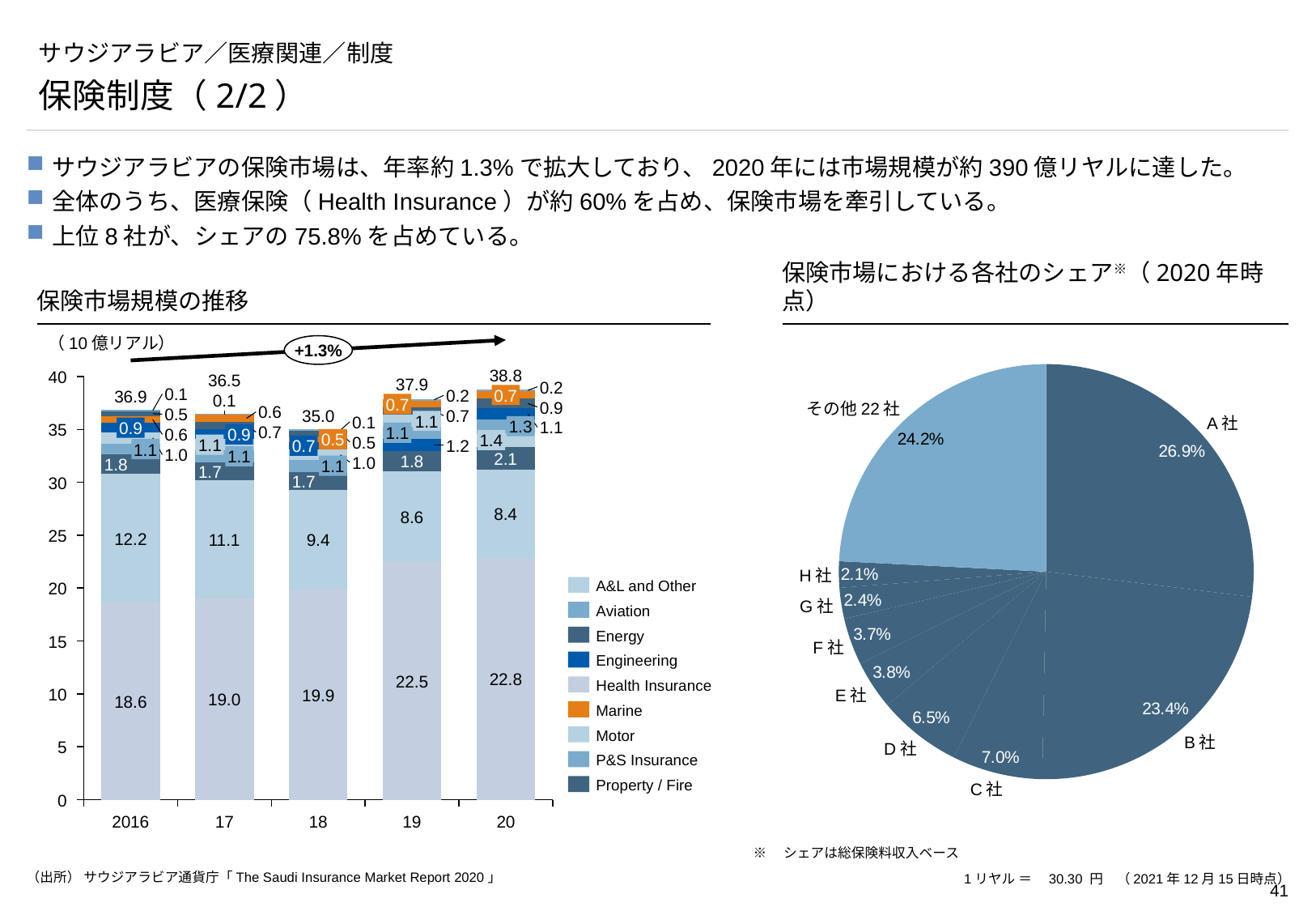
In the pie chart 保険市場における各社のシェア, which is larger, the share of C社 or D社? C社 In the 保険市場規模の推移 chart, what is the Health Insurance value for 2019? 22.5 In the 保険市場規模の推移 chart, what is the total market size shown for 2020? 38.8 In the 保険市場規模の推移 chart, does the Motor value rise or fall from 2016 to 2020? fall In the 保険市場規模の推移 chart, how many series does the legend list? 9 In the pie chart 保険市場における各社のシェア, what share does A社 hold? 26.9% In the pie chart 保険市場における各社のシェア, which named company has the smallest share? H社 In the 保険市場規模の推移 chart, which year has the lowest total market size? 18 In the 保険市場規模の推移 chart, what growth rate is shown in the oval above the bars? +1.3% What kind of chart is the 保険市場における各社のシェア chart on the right? pie chart In the 保険市場規模の推移 chart, what is the difference between the total for 2020 and the total for 2016? 1.9 In the 保険市場規模の推移 chart, what is the Motor value for 2016? 12.2